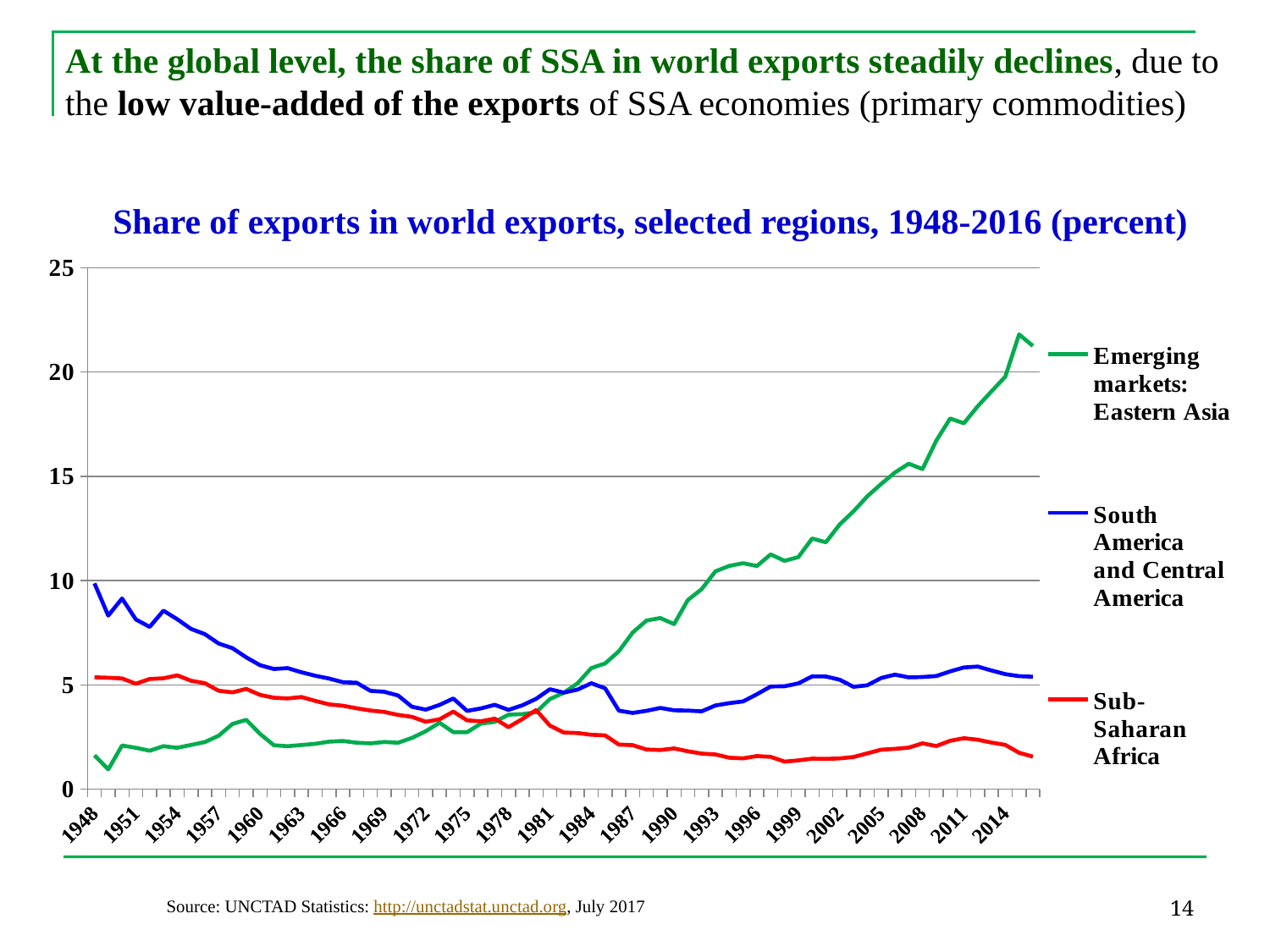
Does the share for Sub-Saharan Africa rise or fall from 1948 to 2016? fall In 1948, which is larger: the share for South America and Central America or the share for Emerging markets: Eastern Asia? South America and Central America In 2014, which is larger: the share for South America and Central America or the share for Sub-Saharan Africa? South America and Central America Which series has the lowest value at the end of the period (2016)? Sub-Saharan Africa Which series has the highest value at the end of the period (2016)? Emerging markets: Eastern Asia What kind of chart is shown on the slide? line chart What is the title of the chart? Share of exports in world exports, selected regions, 1948-2016 (percent) Does the share for Emerging markets: Eastern Asia rise or fall from 1948 to 2016? rise What colour is the line for Sub-Saharan Africa? red How many series does the legend list? 3 Is the value for Sub-Saharan Africa in 1990 greater or less than 5? less